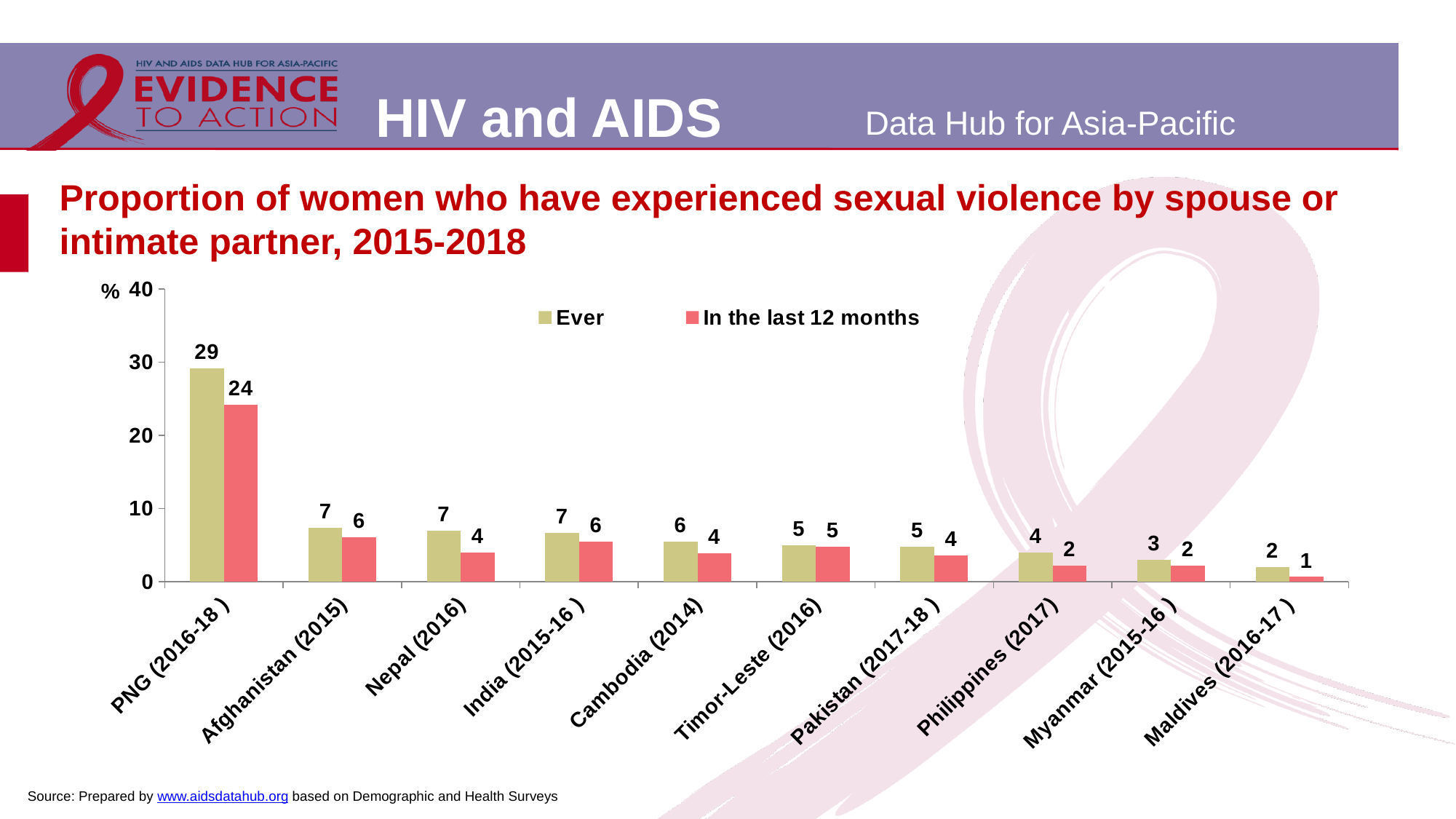
What is the 'Ever' value for PNG (2016-18)? 29 How many series does the legend list? 2 What is the difference between the 'Ever' and 'In the last 12 months' values for PNG (2016-18)? 5 What is the 'In the last 12 months' value for India (2015-16)? 6 What are the two series named in the legend? Ever; In the last 12 months Is the 'Ever' value for PNG (2016-18) greater or less than 20? greater What kind of chart is shown on the slide? Bar chart Which country has the highest 'Ever' value? PNG (2016-18) Do the 'Ever' values generally rise or fall from left to right along the x axis? Fall Which is larger for Nepal (2016): the 'Ever' value or the 'In the last 12 months' value? Ever Which country has the lowest 'In the last 12 months' value? Maldives (2016-17) How many countries are shown on the x axis? 10